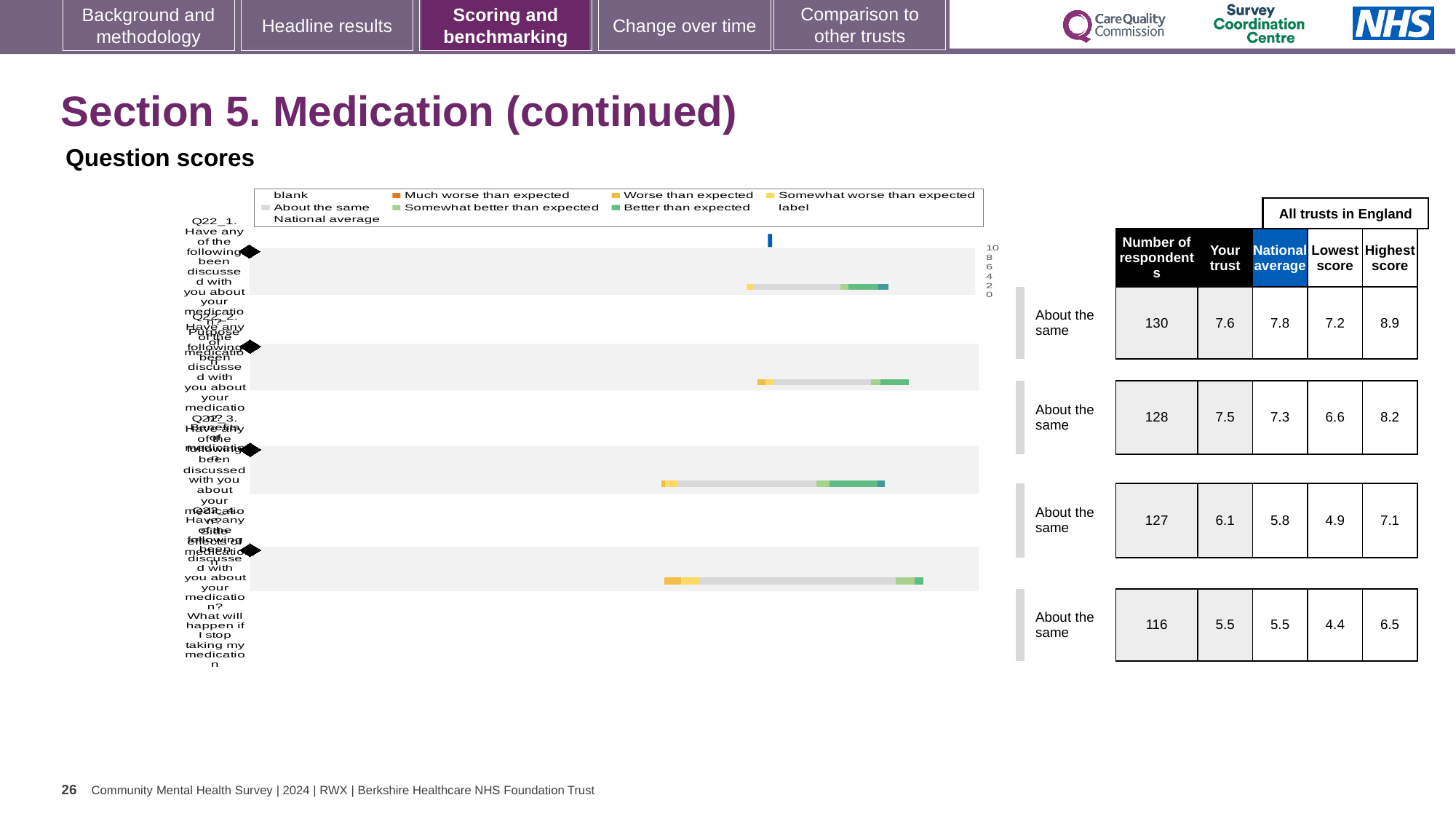
For the second question row, which is larger: the 'Your trust' score or the national average? Your trust Which question row has the lowest 'Your trust' score in the table? the fourth row (5.5) How many question rows (bars) are plotted in the chart? 4 What benchmark category is shown for each of the four question rows? About the same In the table, what is the highest score for the third question row? 7.1 What is the difference between the highest score and the lowest score for the first question row? 1.7 In the table, what is the 'Your trust' score for the first question row (Q22_1)? 7.6 Which question row has the highest number of respondents in the table? the first row (130) In the table, what is the national average for the second question row? 7.3 What colour represents 'Much worse than expected' in the legend? orange In the table, what is the number of respondents for the first question row (Q22_1)? 130 What kind of chart is shown on the slide? bar chart